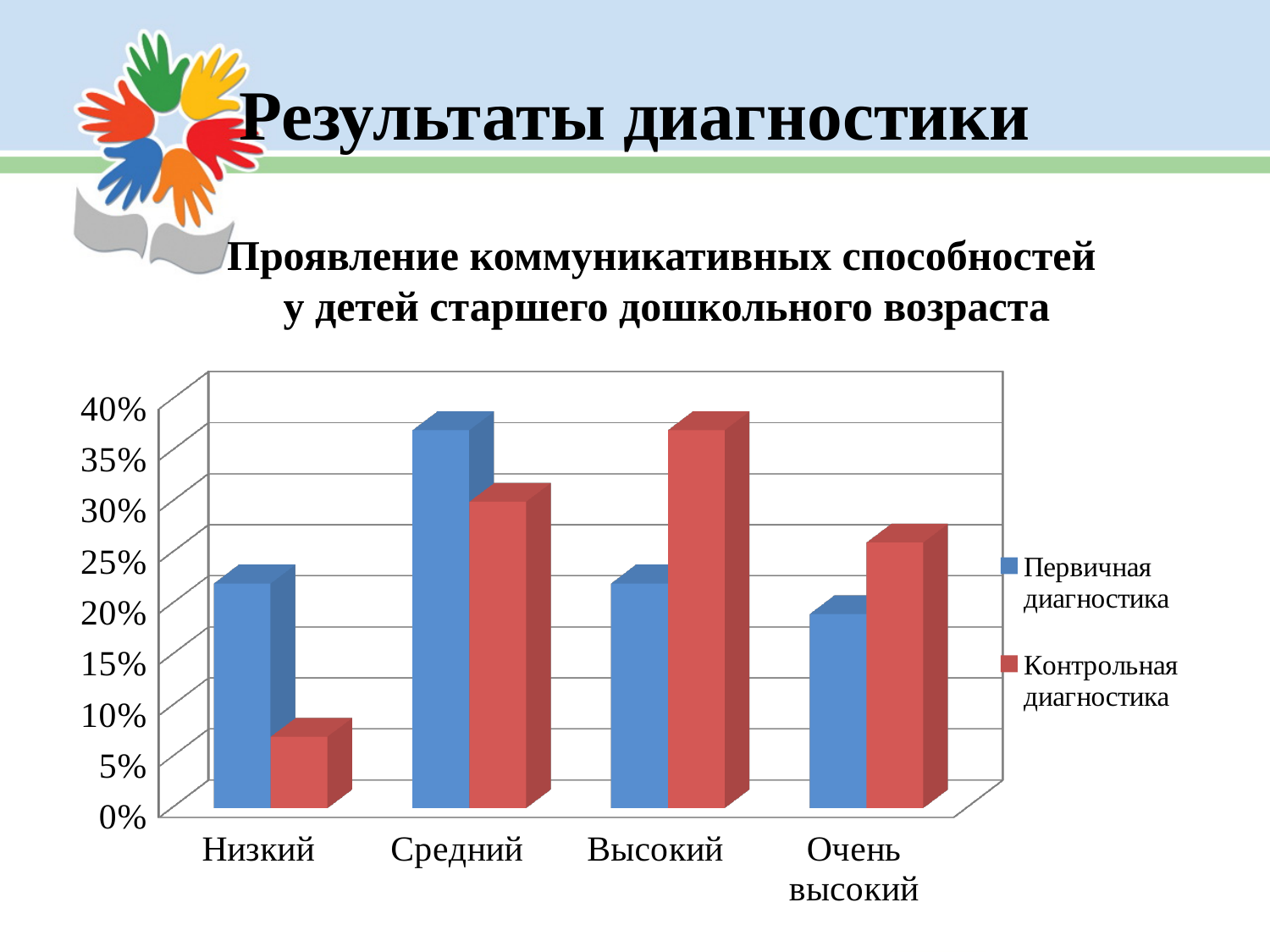
How many categories are shown on the x axis of the chart? 4 Is the value for Контрольная диагностика in the Очень высокий category greater or less than 20%? greater Which category has the highest value for Первичная диагностика? Средний In the Высокий category, which series has the larger value: Первичная диагностика or Контрольная диагностика? Контрольная диагностика Is the value for Контрольная диагностика in the Низкий category greater or less than 10%? less In the Низкий category, which series has the larger value: Первичная диагностика or Контрольная диагностика? Первичная диагностика Which category has the highest value for Контрольная диагностика? Высокий How many series does the legend list? 2 Is the value for Первичная диагностика in the Средний category greater or less than 35%? greater What colour represents the Контрольная диагностика series in the chart? red Which category has the lowest value for Контрольная диагностика? Низкий What kind of chart is shown on the slide? bar chart